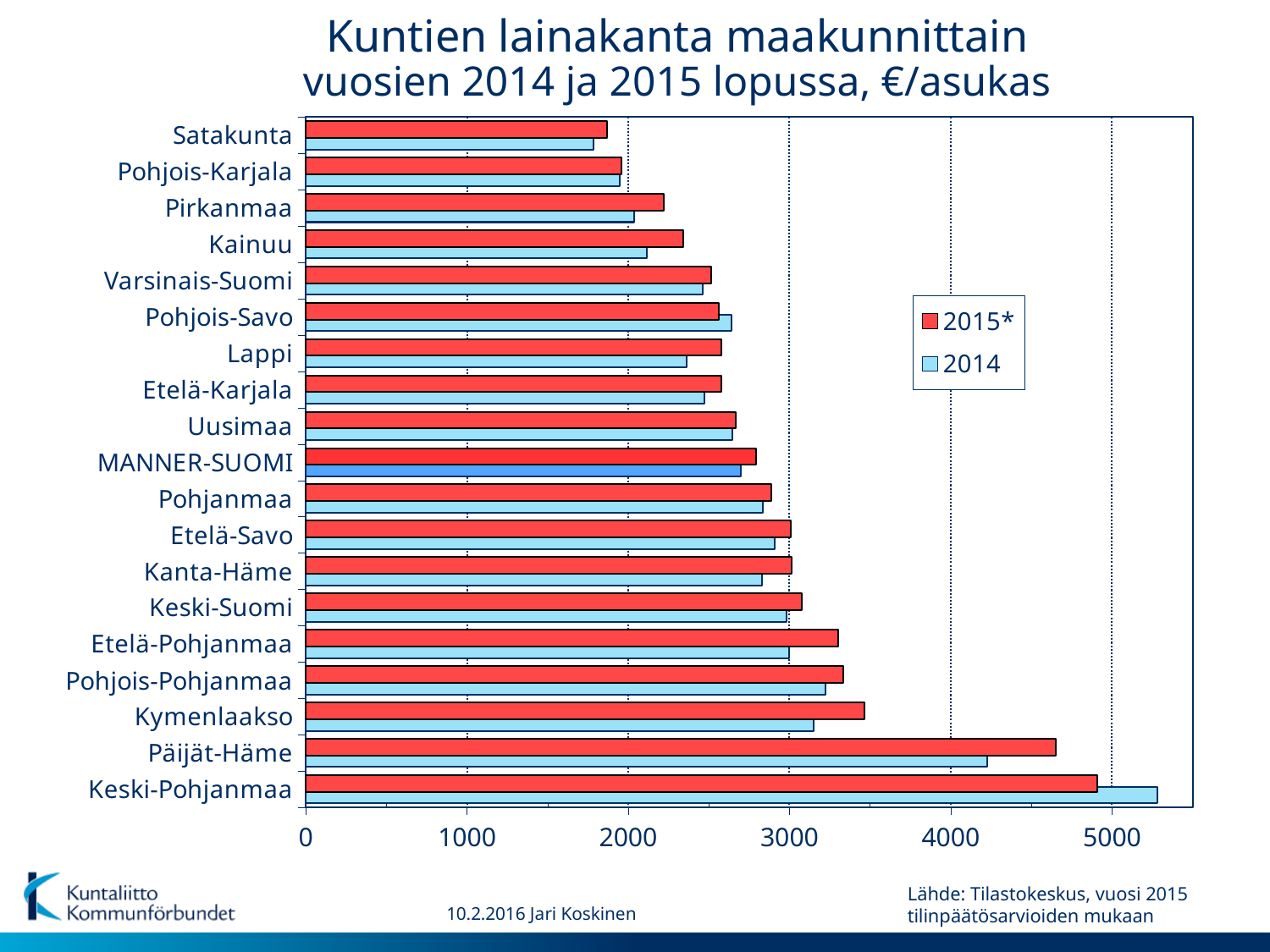
Which region has the highest value for 2015*? Keski-Pohjanmaa How many regions (categories) are shown on the chart? 19 Is the 2014 value for Keski-Pohjanmaa greater or less than 5000? greater Is the 2015* value for Kymenlaakso greater or less than 3000? greater For Keski-Pohjanmaa, which is larger: the 2014 value or the 2015* value? 2014 What are the two entries listed in the legend? 2015* and 2014 What kind of chart is shown on the slide? bar chart How many series does the legend list? 2 Which region has the lowest value for 2014? Satakunta Is the 2015* value for Satakunta greater or less than 2000? less For Lappi, which is larger: the 2014 value or the 2015* value? 2015*